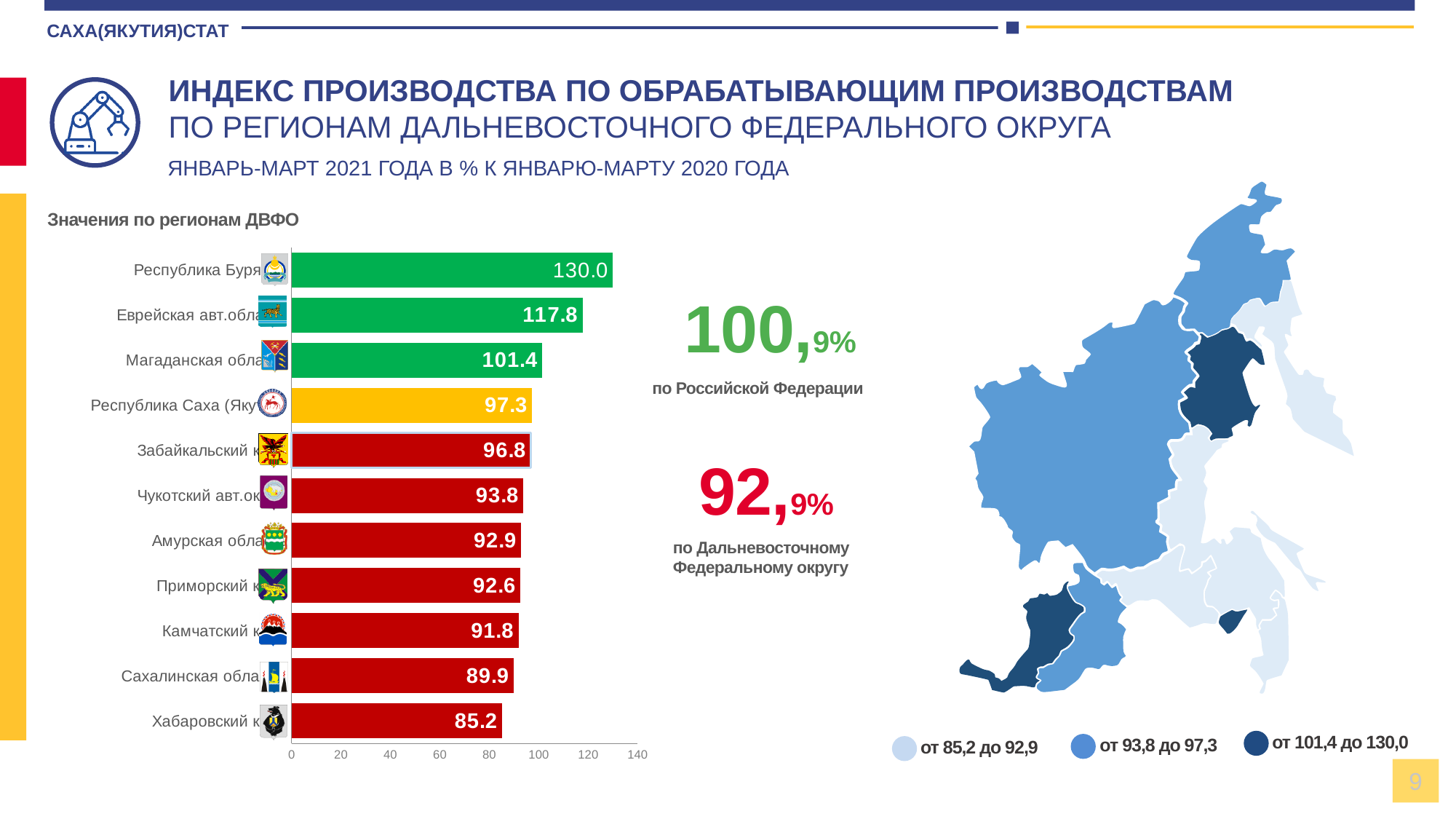
How many regions are shown in the bar chart? 11 Which is larger, the value for Амурская область or the value for Камчатский край? Амурская область What is the value for Республика Бурятия? 130.0 Which region has the lowest value? Хабаровский край What is the difference between the values for Республика Бурятия and Еврейская авт.область? 12.2 What colour is the bar for Республика Саха (Якутия)? yellow Is the value for Сахалинская область greater or less than 100? less What kind of chart is used to show the values by region? bar chart What is the value for Республика Саха (Якутия)? 97.3 Which region has the highest value? Республика Бурятия What is the value for Хабаровский край? 85.2 What is the value for Магаданская область? 101.4